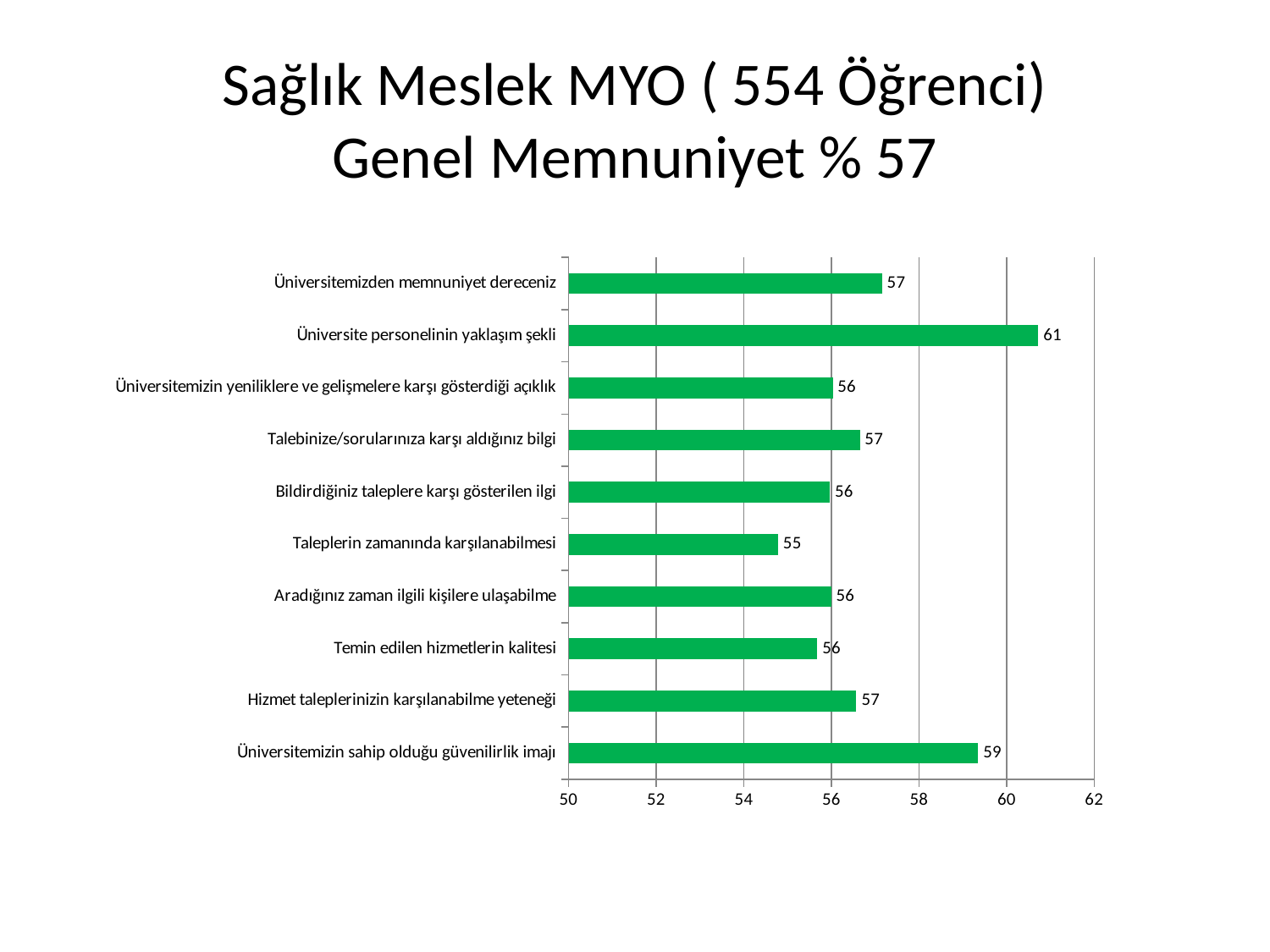
Which category has the lowest value? Taleplerin zamanında karşılanabilmesi What is the title of the slide containing the chart? Sağlık Meslek MYO ( 554 Öğrenci) Genel Memnuniyet % 57 Is the value for "Üniversitemizin sahip olduğu güvenilirlik imajı" greater or less than 58? greater How many categories are plotted in the chart? 10 What is the value for "Taleplerin zamanında karşılanabilmesi"? 55 What is the value for "Üniversitemizin sahip olduğu güvenilirlik imajı"? 59 Which is larger: the value for "Üniversite personelinin yaklaşım şekli" or the value for "Üniversitemizin sahip olduğu güvenilirlik imajı"? Üniversite personelinin yaklaşım şekli What is the value for "Üniversitemizden memnuniyet dereceniz"? 57 Which category has the highest value? Üniversite personelinin yaklaşım şekli What is the difference between the values for "Üniversite personelinin yaklaşım şekli" and "Taleplerin zamanında karşılanabilmesi"? 6 What is the value for "Üniversite personelinin yaklaşım şekli"? 61 What kind of chart is shown on the slide? bar chart